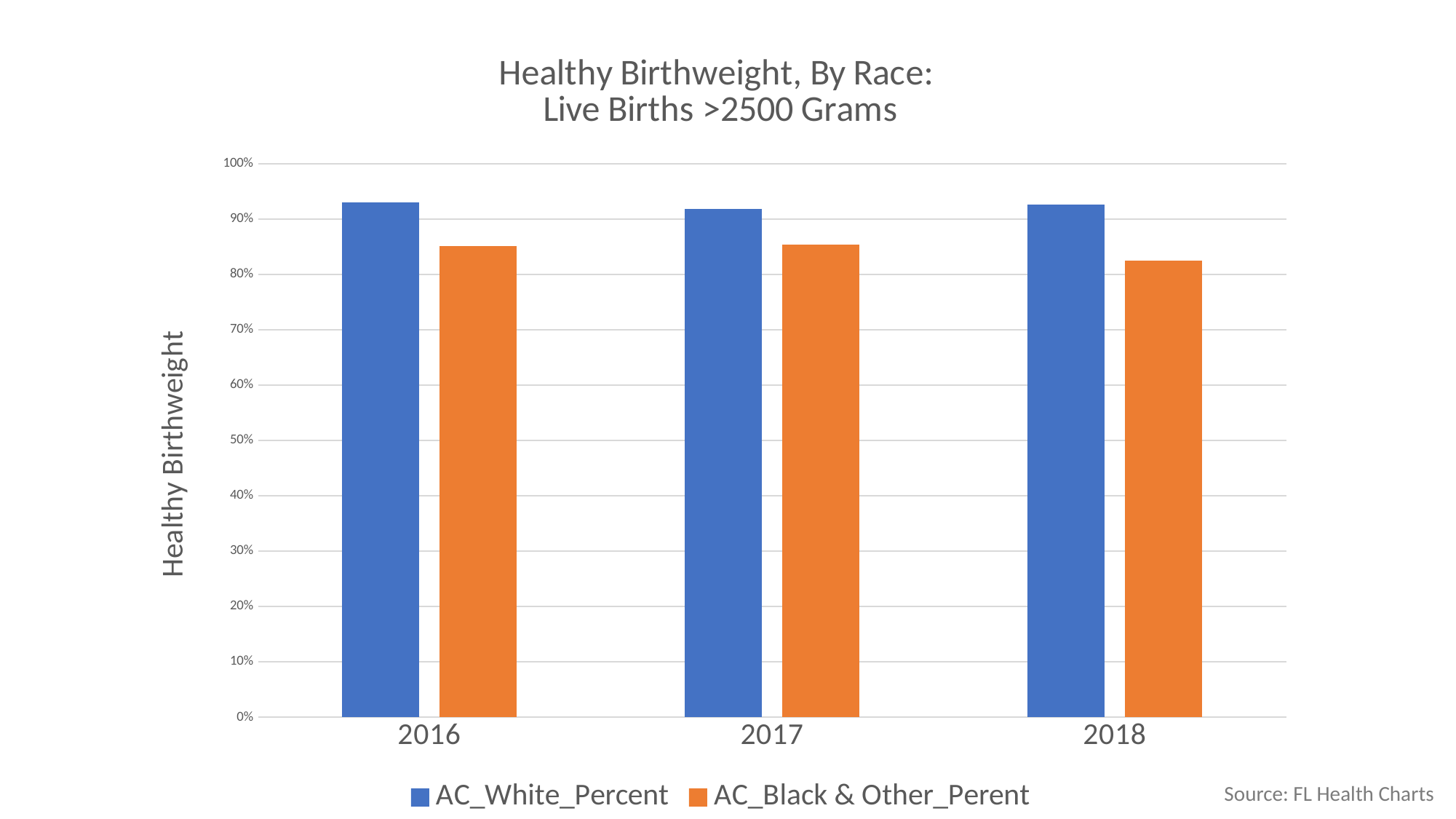
Is the value for AC_White_Percent in 2016 greater or less than 90%? greater How many years are shown on the x axis? 3 Is the AC_White_Percent value higher in every year than the AC_Black & Other_Perent value? Yes In which year is the AC_Black & Other_Perent value lowest? 2018 What is the label on the vertical axis? Healthy Birthweight What is the title of the chart? Healthy Birthweight, By Race: Live Births >2500 Grams How many series does the legend list? 2 In 2017, which series has the larger value, AC_White_Percent or AC_Black & Other_Perent? AC_White_Percent What kind of chart is shown on the slide? bar chart Is the value for AC_Black & Other_Perent in 2018 greater or less than 90%? less Which series is shown in orange? AC_Black & Other_Perent Is the value for AC_Black & Other_Perent in 2017 greater or less than 80%? greater